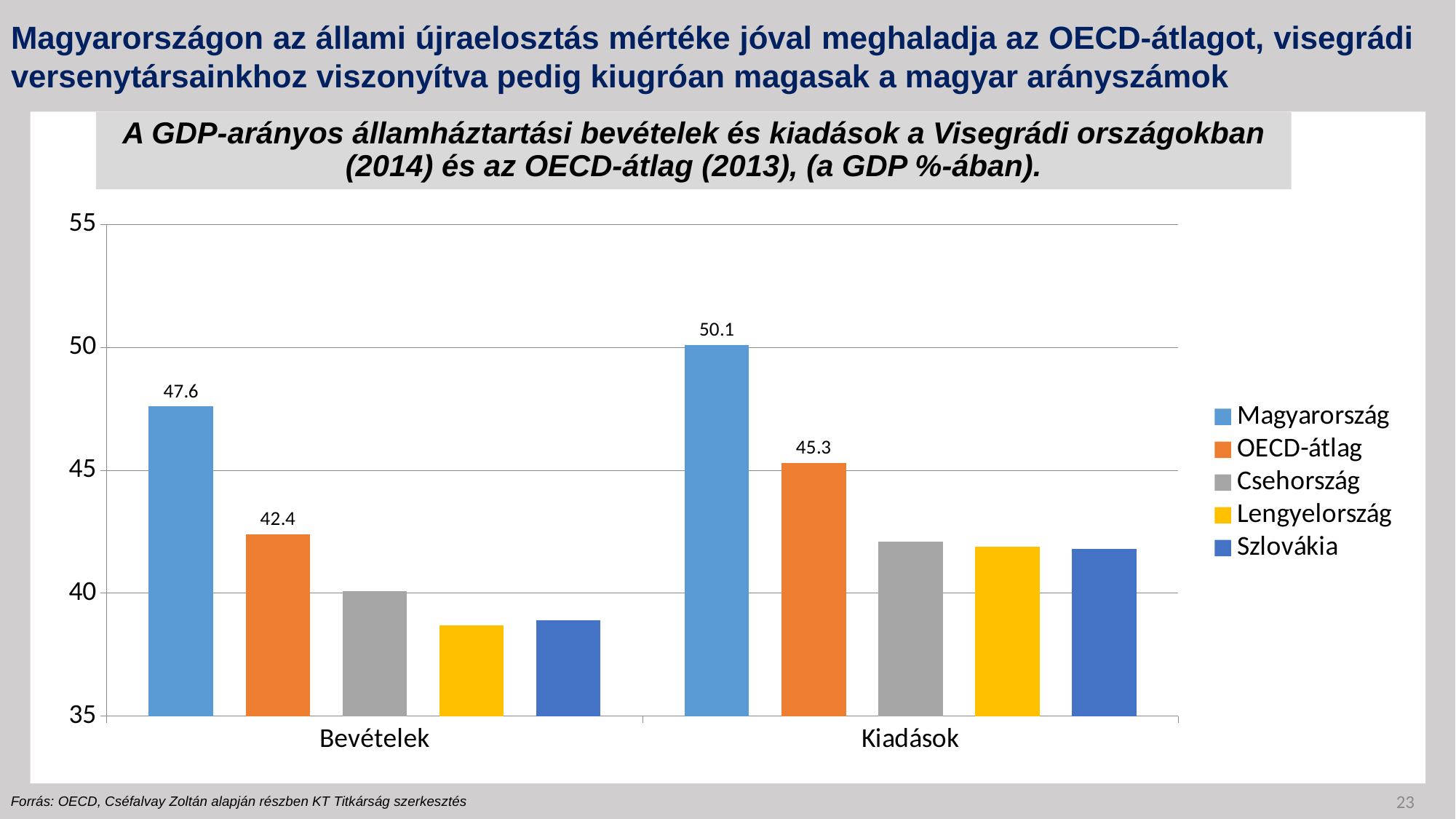
Is the value for Lengyelország in the Bevételek category greater or less than 40? less What is the value for OECD-átlag in the Kiadások category? 45.3 What is the value for Magyarország in the Bevételek category? 47.6 What kind of chart is shown on the slide? bar chart Which series has the highest value in the Kiadások category? Magyarország How many categories are shown on the x axis? 2 What is the difference between the Magyarország values for Kiadások and Bevételek? 2.5 What is the value for Magyarország in the Kiadások category? 50.1 How many series does the legend list? 5 What is the difference between the Magyarország and OECD-átlag values in the Bevételek category? 5.2 Which is larger: the OECD-átlag value for Bevételek or for Kiadások? Kiadások Is the value for Csehország in the Kiadások category greater or less than 45? less